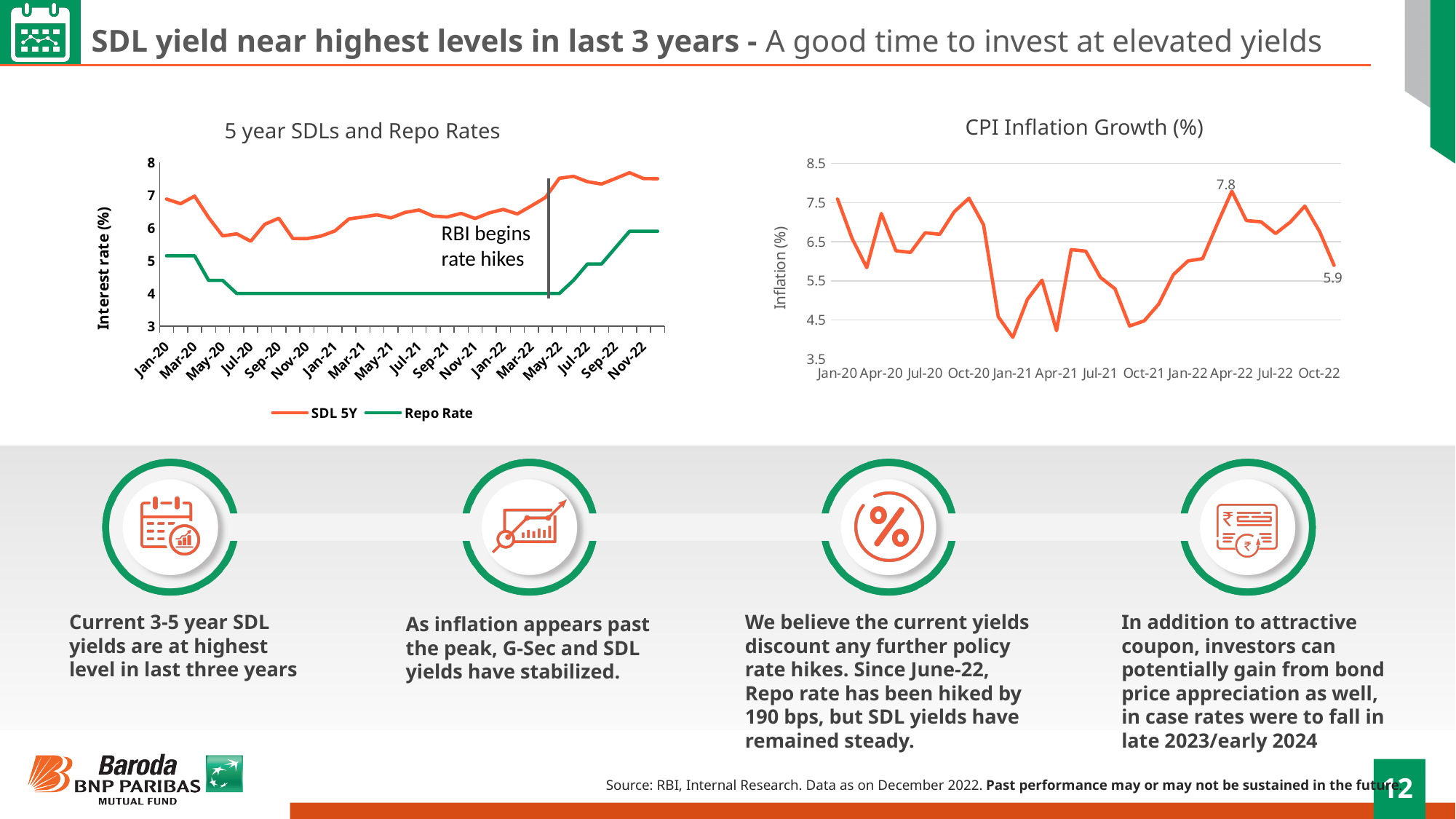
In the "CPI Inflation Growth (%)" chart, what is the difference between the two labelled values, 7.8 and 5.9? 1.9 In the "CPI Inflation Growth (%)" chart, what is the value labelled at the last point of the line? 5.9 In the "5 year SDLs and Repo Rates" chart, is the Repo Rate in Jan-21 greater or less than 5? less In the "CPI Inflation Growth (%)" chart, is the value in Jan-21 greater or less than 4.5? less In the "5 year SDLs and Repo Rates" chart, what does the annotation next to the vertical line say? RBI begins rate hikes In the "CPI Inflation Growth (%)" chart, what is the highest labelled value? 7.8 In the "5 year SDLs and Repo Rates" chart, does the Repo Rate rise or fall between May-22 and Nov-22? rise How many series does the legend of the "5 year SDLs and Repo Rates" chart list? 2 In the "5 year SDLs and Repo Rates" chart, which series is higher in Jan-20, SDL 5Y or Repo Rate? SDL 5Y In the "5 year SDLs and Repo Rates" chart, is the SDL 5Y value in Nov-22 greater or less than 7? greater What kind of chart is the "5 year SDLs and Repo Rates" chart? line chart What are the two series named in the legend of the "5 year SDLs and Repo Rates" chart? SDL 5Y and Repo Rate